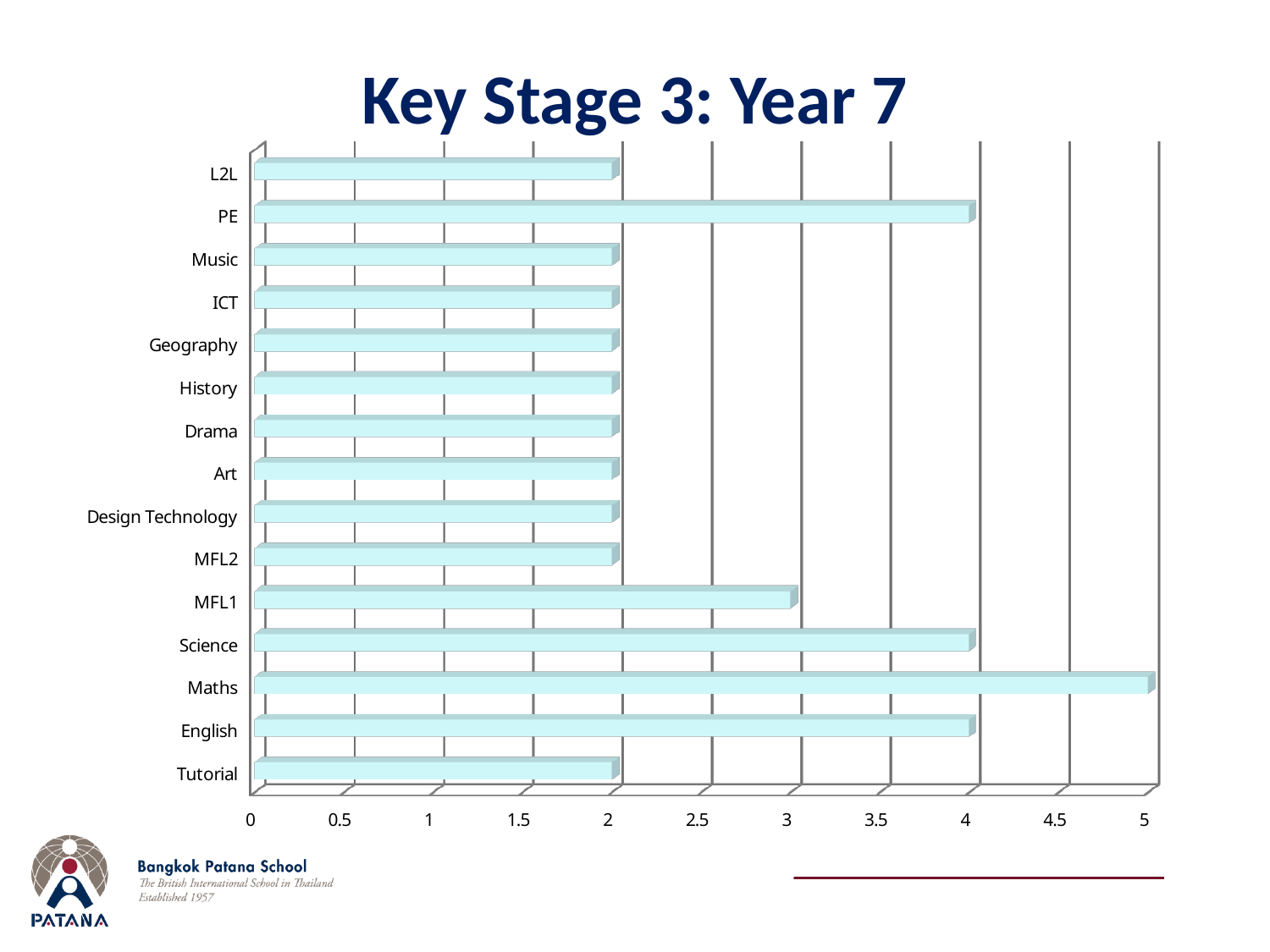
Is the value for English greater or less than 3? greater What is the difference between the values for Maths and MFL1? 2 What is the title of the chart? Key Stage 3: Year 7 What is the value for Maths? 5 What is the value for Science? 4 What is the value for MFL1? 3 What is the value for Tutorial? 2 Which subject has the highest value? Maths How many subjects are listed on the chart? 15 Which is larger, the value for PE or the value for Music? PE What kind of chart is shown on the slide? bar chart Is the value for Geography greater or less than 3? less